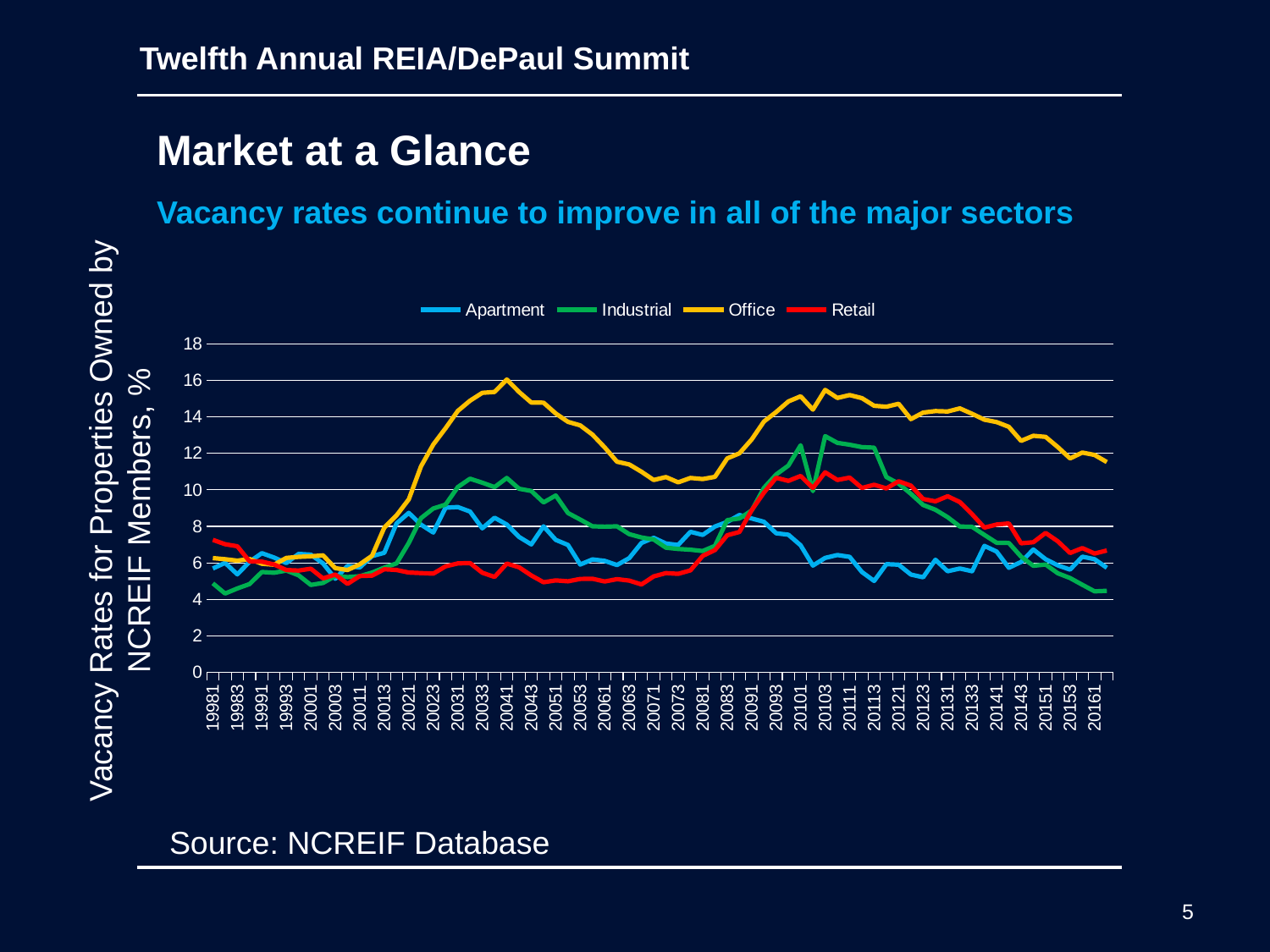
What are the series listed in the legend? Apartment, Industrial, Office, Retail Is the Office value at 20041 greater or less than 14? greater Is the Office value at 20161 greater or less than 10? greater What kind of chart is shown on the slide? line chart How many series does the legend list? 4 Is the Industrial value at 20161 greater or less than 6? less Which series has the highest vacancy rate at 20041? Office Does the Office vacancy rate rise or fall from 20101 to 20161? fall Which series has the lowest vacancy rate at 20161? Industrial Which series has the highest vacancy rate at 20101? Office At 20111, which is higher, Industrial or Retail? Industrial What is the label on the vertical axis? Vacancy Rates for Properties Owned by NCREIF Members, %